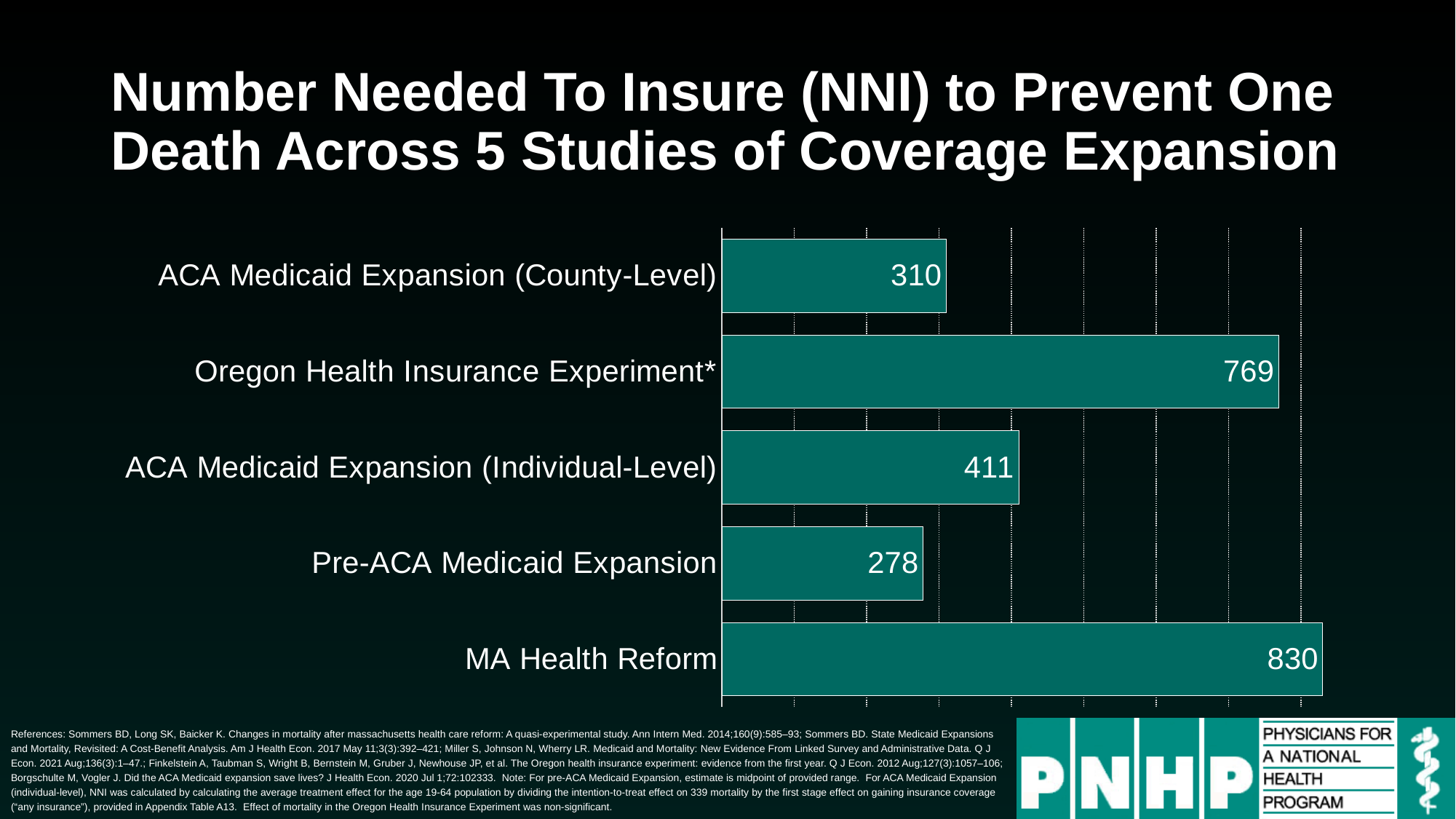
What is the NNI value for ACA Medicaid Expansion (Individual-Level)? 411 Which study has the highest NNI value? MA Health Reform What is the NNI value for the Oregon Health Insurance Experiment*? 769 What type of chart is shown on the slide? Bar chart What is the NNI value for Pre-ACA Medicaid Expansion? 278 Which study has the lowest NNI value? Pre-ACA Medicaid Expansion Which has a larger NNI value: ACA Medicaid Expansion (County-Level) or Pre-ACA Medicaid Expansion? ACA Medicaid Expansion (County-Level) What is the NNI value for MA Health Reform? 830 How many studies are shown in the chart? 5 What is the difference between the NNI for MA Health Reform and the Oregon Health Insurance Experiment*? 61 What is the title of the slide? Number Needed To Insure (NNI) to Prevent One Death Across 5 Studies of Coverage Expansion What is the difference between the NNI for ACA Medicaid Expansion (Individual-Level) and ACA Medicaid Expansion (County-Level)? 101